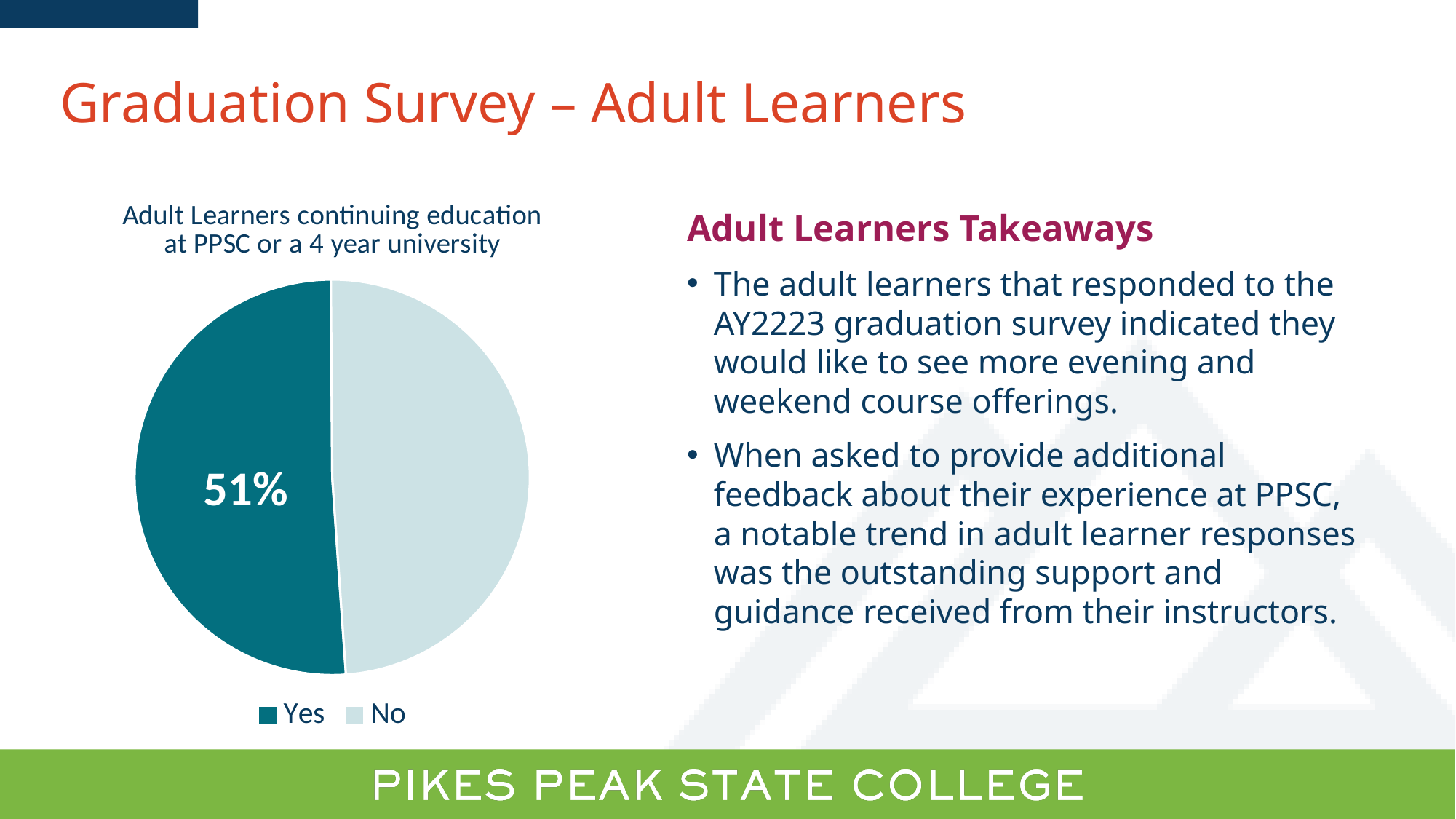
How many slices does the pie chart have? 2 Which category has the largest share of the pie chart? Yes What are the two legend entries of the pie chart? Yes and No Is the Yes share of the pie chart greater or less than 50%? greater Which slice of the pie chart is larger, Yes or No? Yes How many entries does the legend of the pie chart list? 2 What is the title of the pie chart? Adult Learners continuing education at PPSC or a 4 year university What kind of chart is shown on the slide? pie chart What percentage of adult learners answered Yes to continuing education at PPSC or a 4 year university? 51%